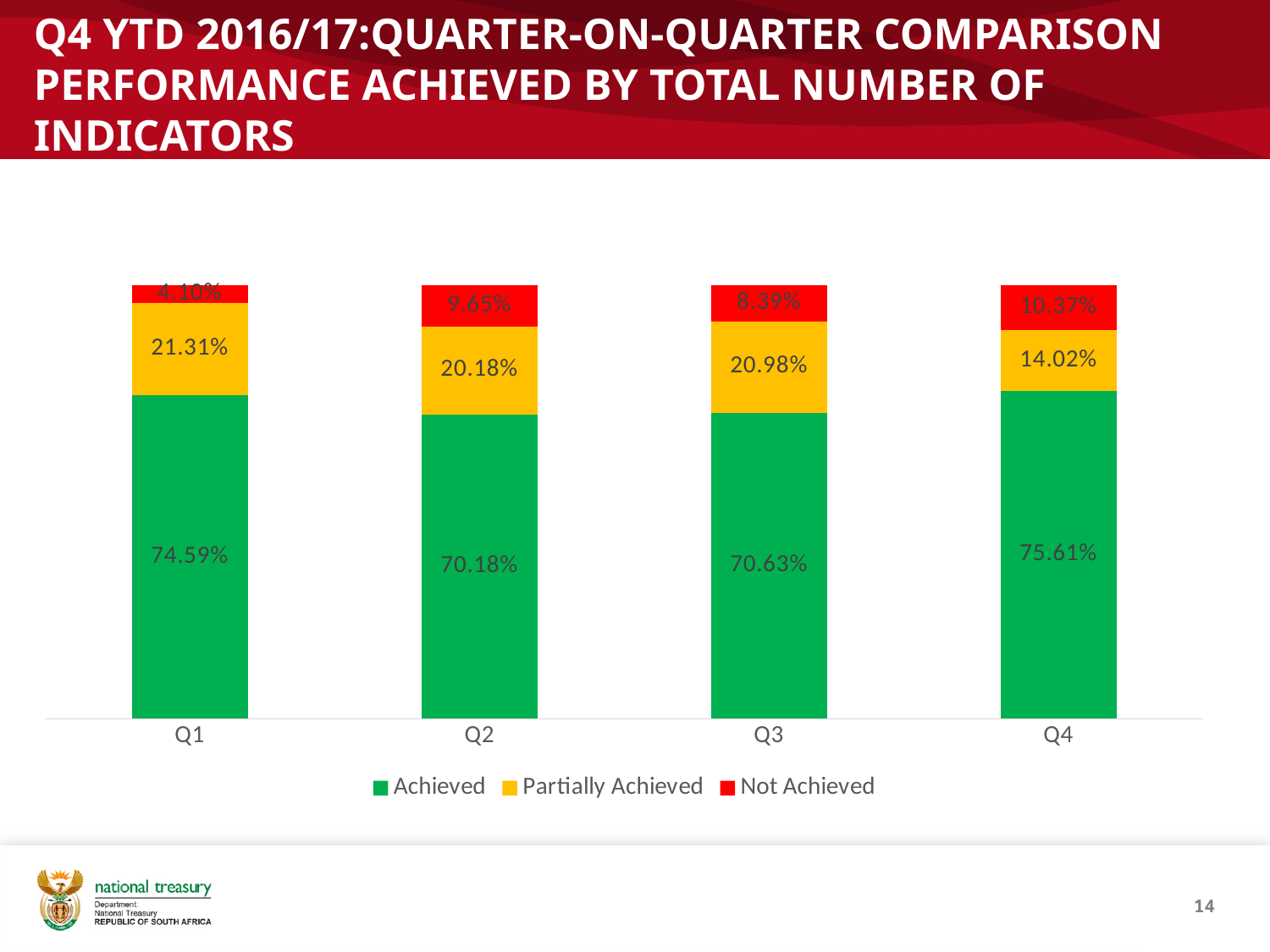
What is the Achieved percentage for Q4? 75.61% How many series does the legend list? 3 What is the Partially Achieved percentage for Q2? 20.18% What is the Achieved percentage for Q1? 74.59% What kind of chart is shown on the slide? Stacked bar chart Which quarter has the highest Not Achieved percentage? Q4 Which quarter has the lowest Partially Achieved percentage? Q4 What is the difference between the Achieved percentages for Q4 and Q2? 5.43% What is the Not Achieved percentage for Q3? 8.39% How many quarters are shown on the x axis? 4 Is the Partially Achieved percentage larger for Q1 or Q4? Q1 Which quarter has the highest Achieved percentage? Q4